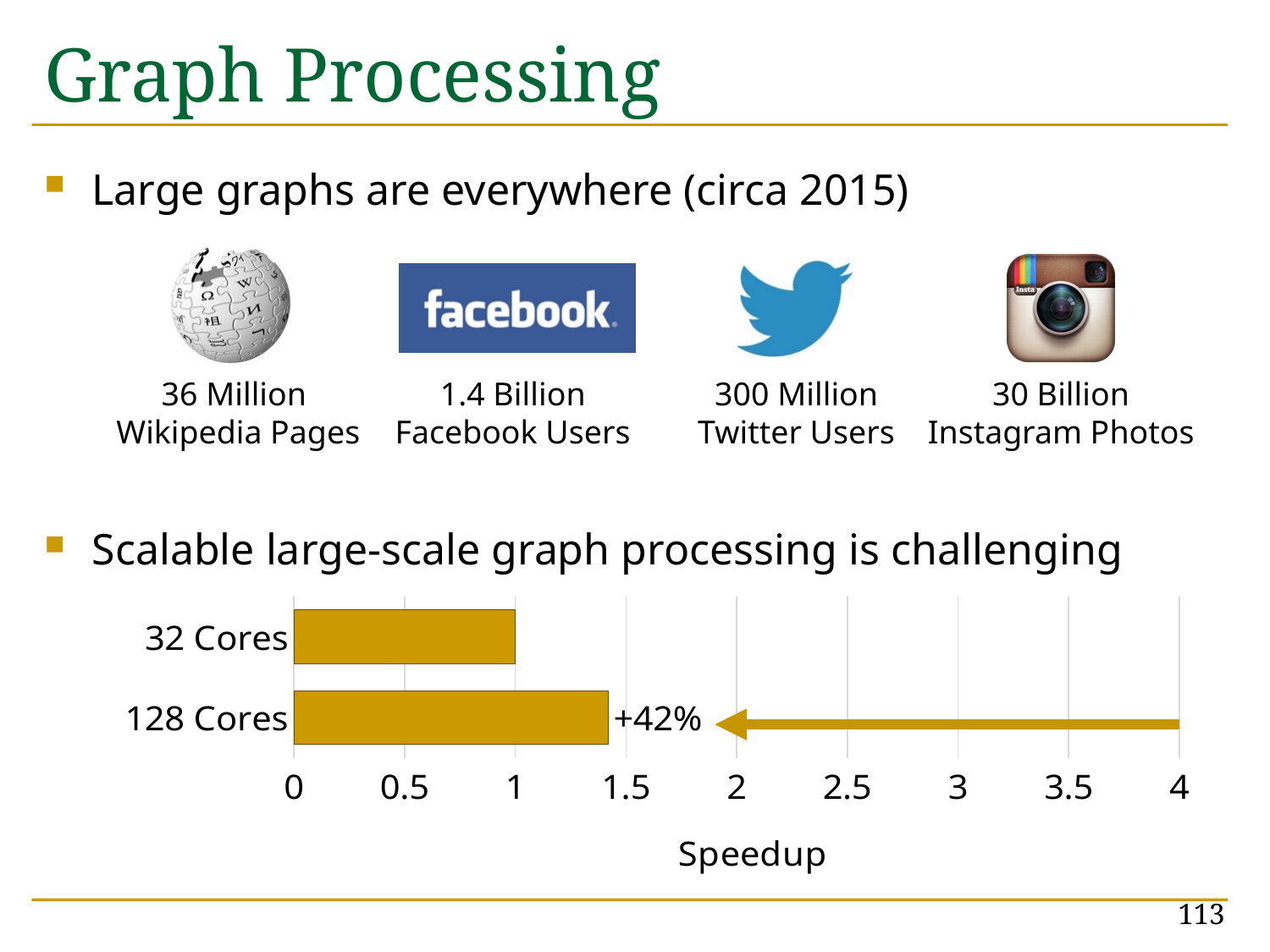
What kind of chart is shown on the slide? bar chart Is the speedup for 128 Cores greater or less than 1? greater Which has a larger speedup, 32 Cores or 128 Cores? 128 Cores What is the label of the x axis of the chart? Speedup What annotation is printed next to the 128 Cores bar? +42% Which category has the highest speedup? 128 Cores How many categories are plotted in the chart? 2 What is the speedup value for 32 Cores? 1 Is the speedup for 128 Cores greater or less than 1.5? less Is the speedup for 32 Cores greater or less than 2? less Which category has the lowest speedup? 32 Cores